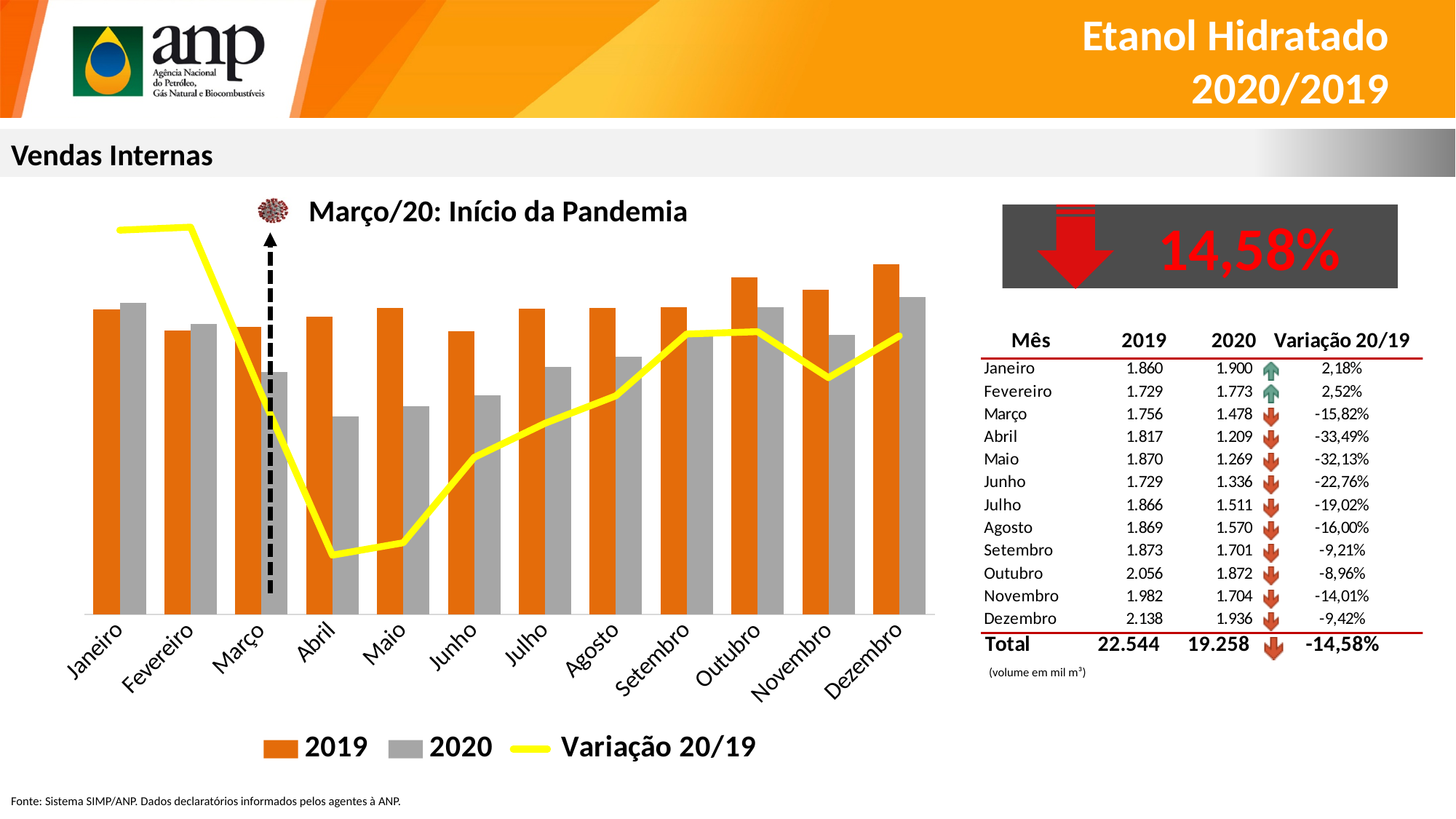
How many series does the chart legend list? 3 How many months are shown on the x axis of the chart? 12 According to the table on the slide, what is the Variação 20/19 for Março? -15,82% Is the 2019 bar or the 2020 bar taller for Janeiro? 2020 Which month has the highest 2019 bar? Dezembro What kind of chart is shown on the slide? Combined bar and line chart Does the Variação 20/19 line rise or fall from Fevereiro to Abril? Fall Is the 2019 bar or the 2020 bar taller for Maio? 2019 Which month has the lowest 2020 bar? Abril According to the table on the slide, what is the 2020 value for Abril? 1.209 What event does the annotation above the Março bars mark? Março/20: Início da Pandemia According to the table on the slide, what is the difference between the 2019 and 2020 values for Dezembro? 202